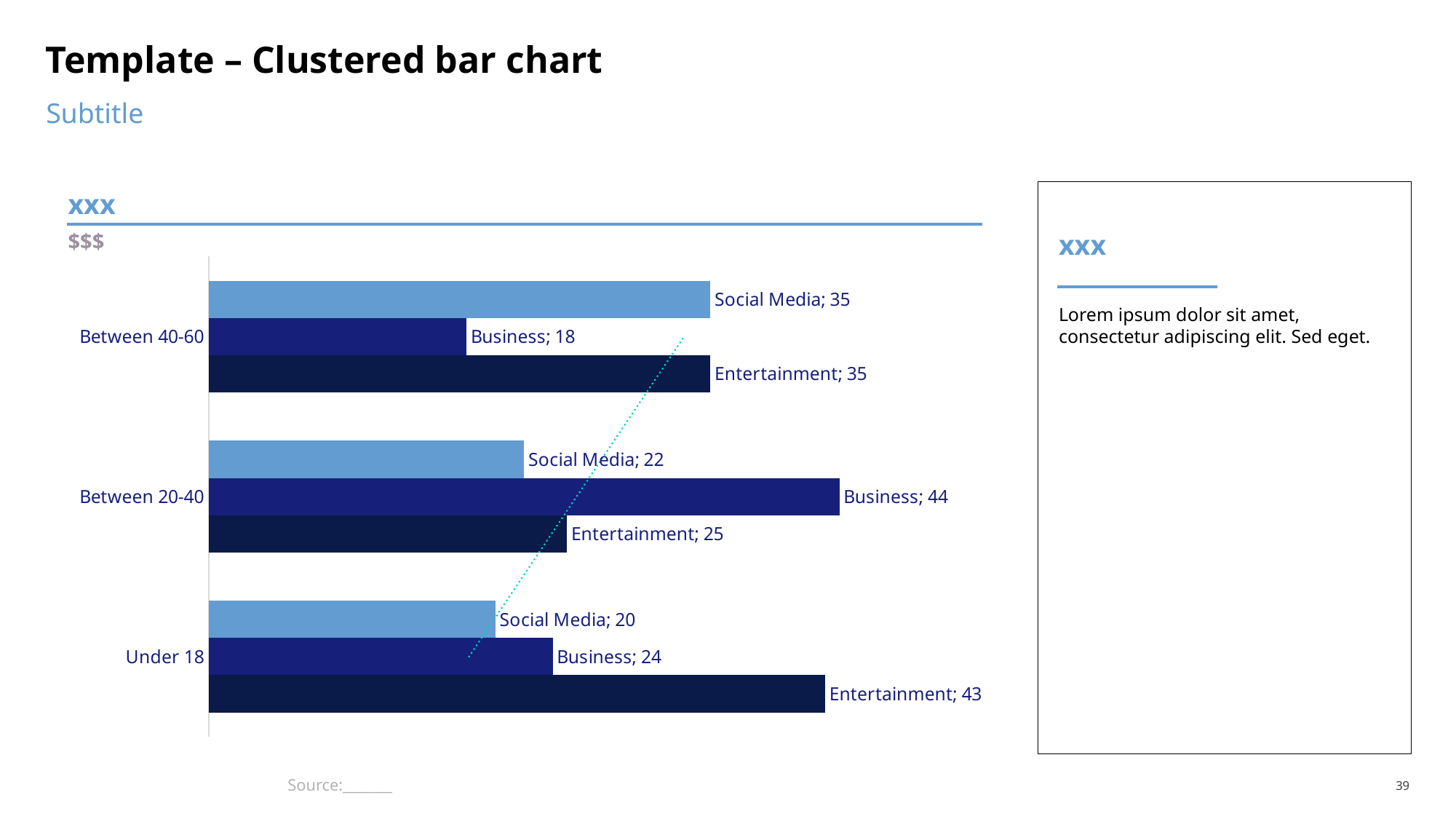
What is the Social Media value for Between 40-60? 35 What is the Business value for Between 20-40? 44 Which category has the lowest Business value? Between 40-60 What is the difference between the Business values for Between 20-40 and Under 18? 20 Which category has the highest Social Media value? Between 40-60 What is the Entertainment value for Under 18? 43 How many age categories are shown on the chart? 3 What is the total of the three values for Under 18? 87 Which is larger for Between 20-40: Social Media or Entertainment? Entertainment What kind of chart is shown on the slide? Bar chart What is the Business value for Under 18? 24 How many series are plotted for each category? 3